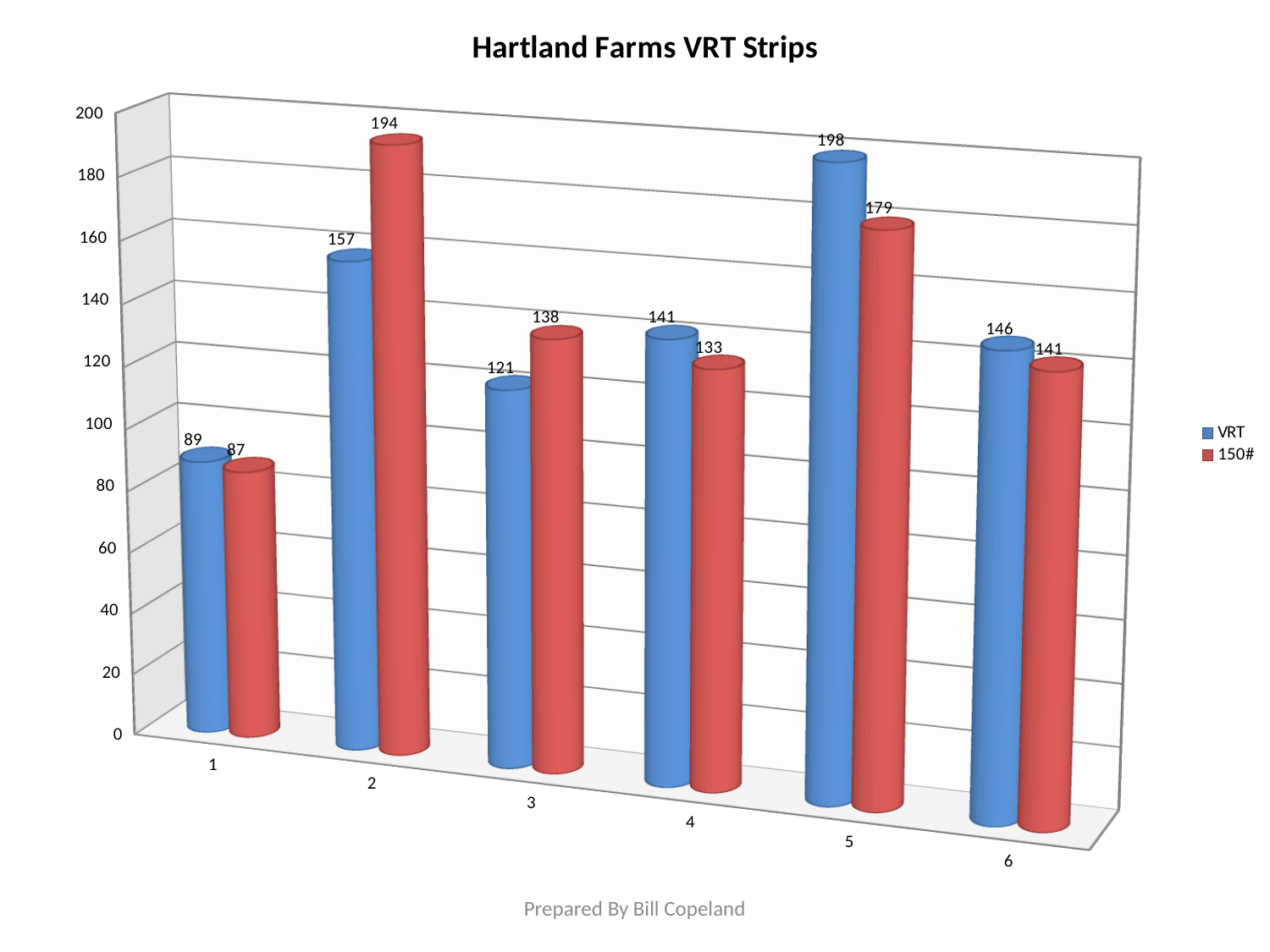
For strip 4, which series has the larger value, VRT or 150#? VRT What is the difference between the VRT and 150# values for strip 2? 37 What is the 150# value for strip 3? 138 Which strip has the highest VRT value? 5 How many strips are shown on the x axis? 6 Which strip has the lowest 150# value? 1 What is the title of the chart? Hartland Farms VRT Strips What colour are the 150# bars? Red What kind of chart is shown? Bar chart How many series does the legend list? 2 What is the 150# value for strip 5? 179 What is the VRT value for strip 2? 157